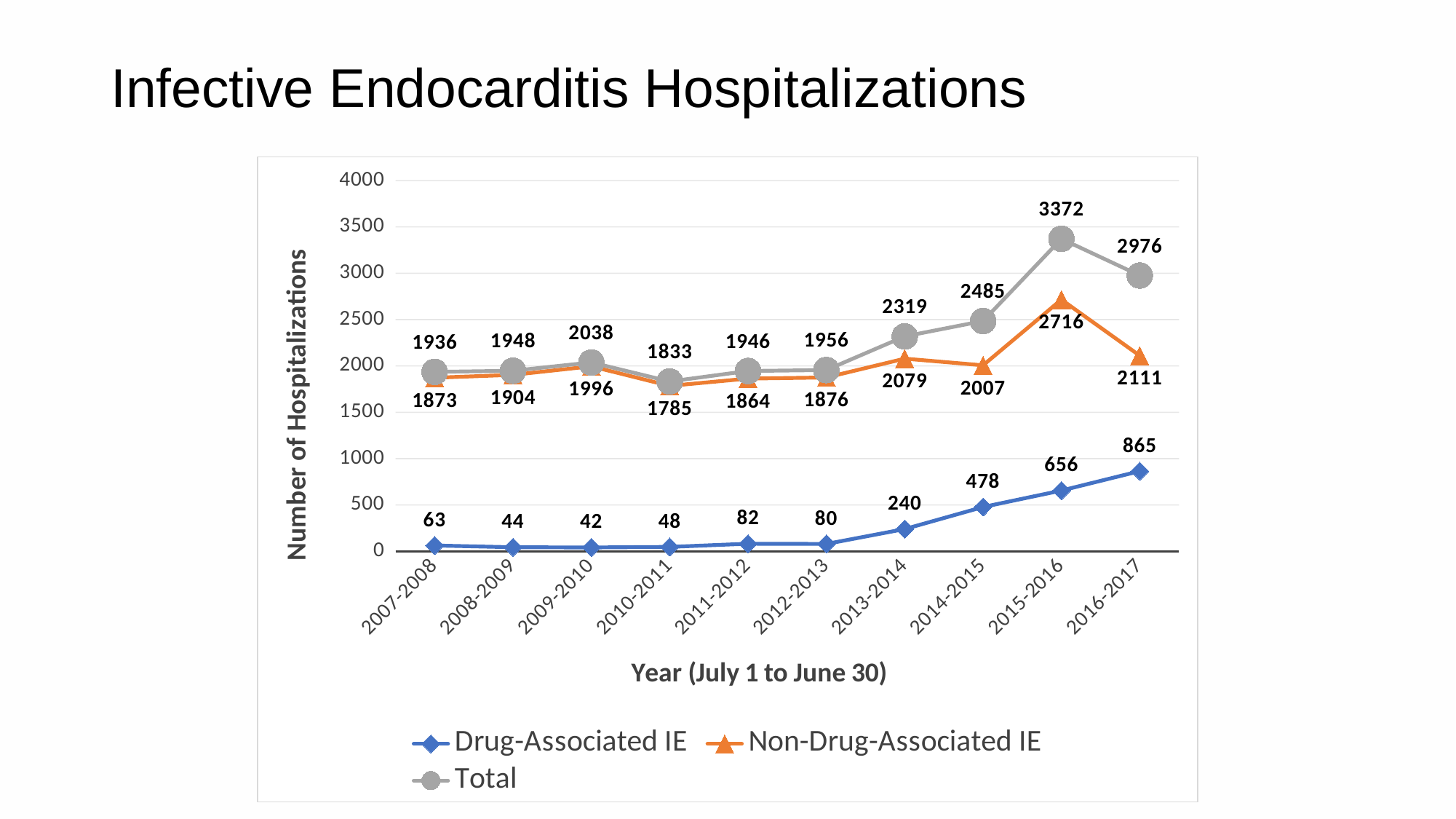
What is the label of the y axis? Number of Hospitalizations What is the Total number of hospitalizations in 2015-2016? 3372 Which is larger: Non-Drug-Associated IE in 2013-2014 or in 2014-2015? 2013-2014 How many years are plotted along the x axis? 10 What is the value for Drug-Associated IE in 2016-2017? 865 In which year is Drug-Associated IE lowest? 2009-2010 Does Drug-Associated IE generally rise or fall from 2012-2013 to 2016-2017? rise What type of chart is shown on the slide? line chart What is the difference between the Total in 2015-2016 and the Total in 2016-2017? 396 How many series does the legend list? 3 What is the value for Non-Drug-Associated IE in 2010-2011? 1785 In which year is the Total highest? 2015-2016